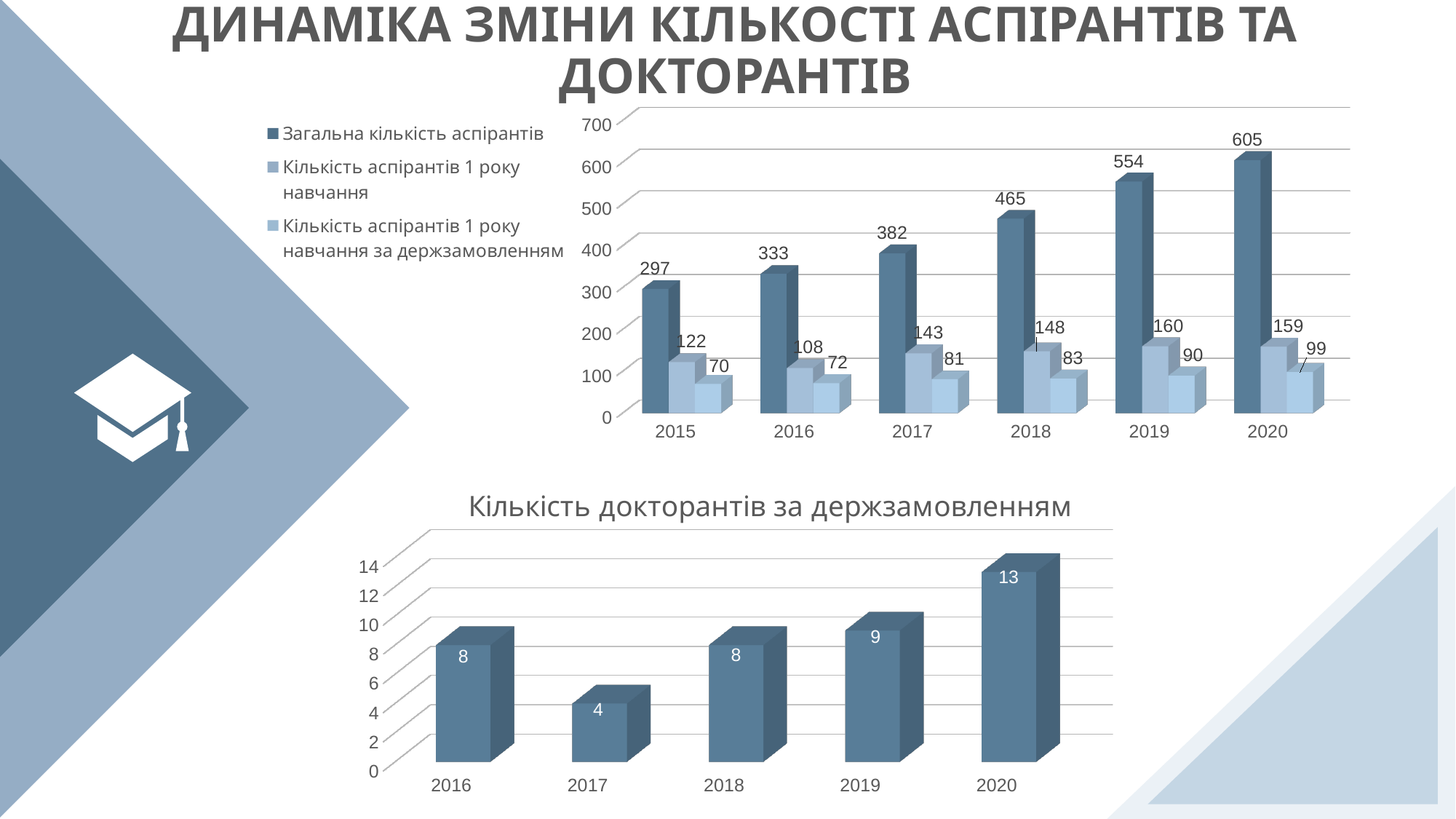
In the top chart, what is the value of 'Кількість аспірантів 1 року навчання' for 2017? 143 In the top chart, which is larger: 'Кількість аспірантів 1 року навчання' in 2016 or in 2018? 2018 What kind of chart is 'Кількість докторантів за держзамовленням'? bar chart In the chart 'Кількість докторантів за держзамовленням', how many years are shown on the x axis? 5 In the chart 'Кількість докторантів за держзамовленням', which year has the highest value? 2020 In the top chart, how many series does the legend list? 3 In the chart 'Кількість докторантів за держзамовленням', what is the value for 2017? 4 In the top chart, what is the difference between 'Загальна кількість аспірантів' in 2020 and in 2019? 51 In the top chart, what is the value of 'Загальна кількість аспірантів' for 2020? 605 In the top chart, does 'Загальна кількість аспірантів' rise or fall from 2015 to 2020? rise In the top chart, what is the value of 'Кількість аспірантів 1 року навчання за держзамовленням' for 2019? 90 In the top chart, which year has the lowest value for 'Загальна кількість аспірантів'? 2015